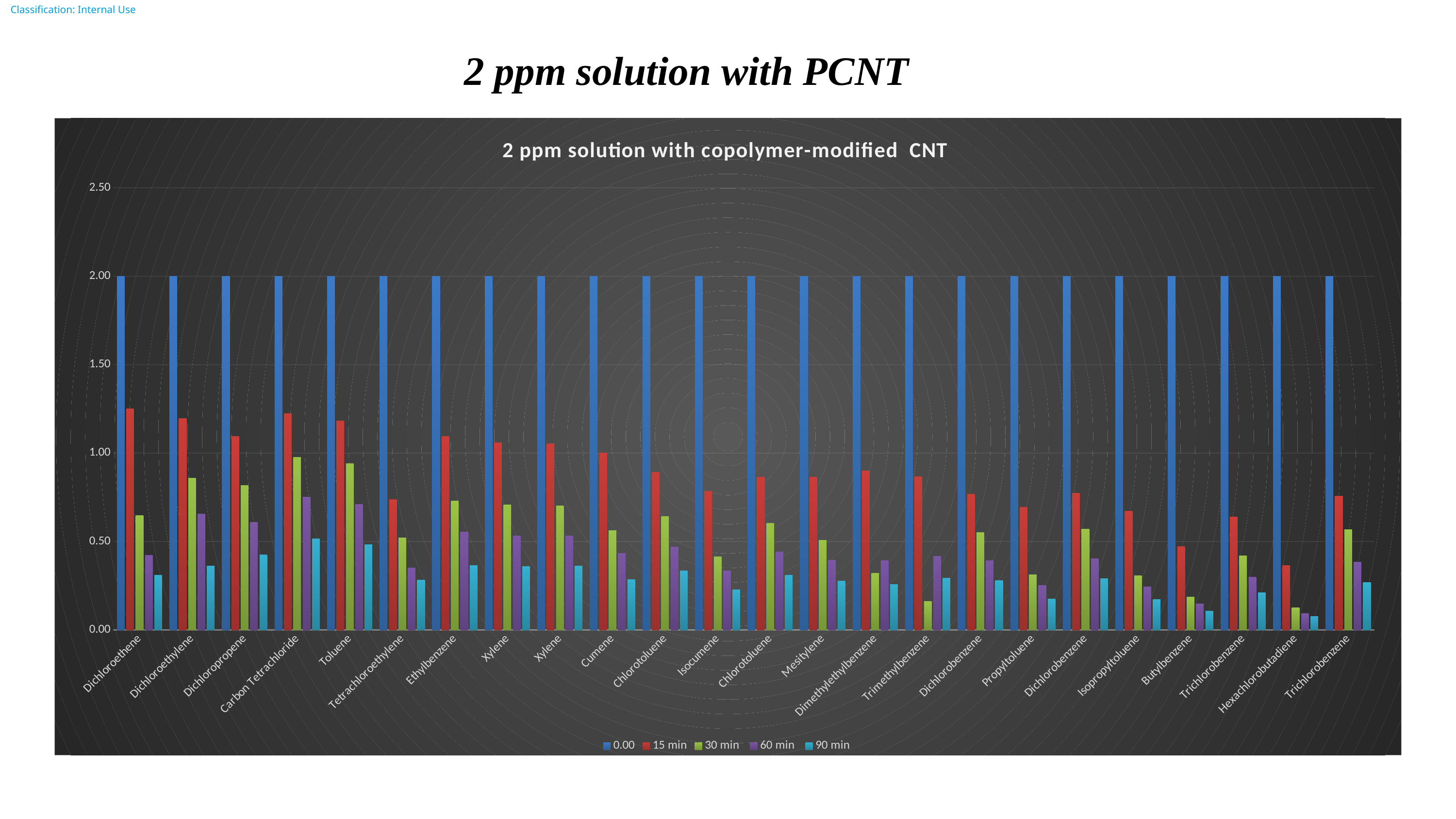
How many categories are shown along the x axis? 24 Which category has the lowest 90 min value? Hexachlorobutadiene Is the 90 min value for Dichloroethene greater or less than 0.50? less What kind of chart is shown on the slide? bar chart For Dichloroethene, do the bars rise or fall going from the 0.00 series to the 90 min series? fall Is the 15 min value for Dichloroethene greater or less than 1.00? greater Which is larger: the 15 min value for Dichloroethene or the 15 min value for Butylbenzene? Dichloroethene Is the 15 min value for Hexachlorobutadiene greater or less than 0.50? less How many series does the legend list? 5 What is the title shown inside the chart area? 2 ppm solution with copolymer-modified CNT Which category has the lowest 15 min value? Hexachlorobutadiene What is the value of the 0.00 series for Toluene? 2.00